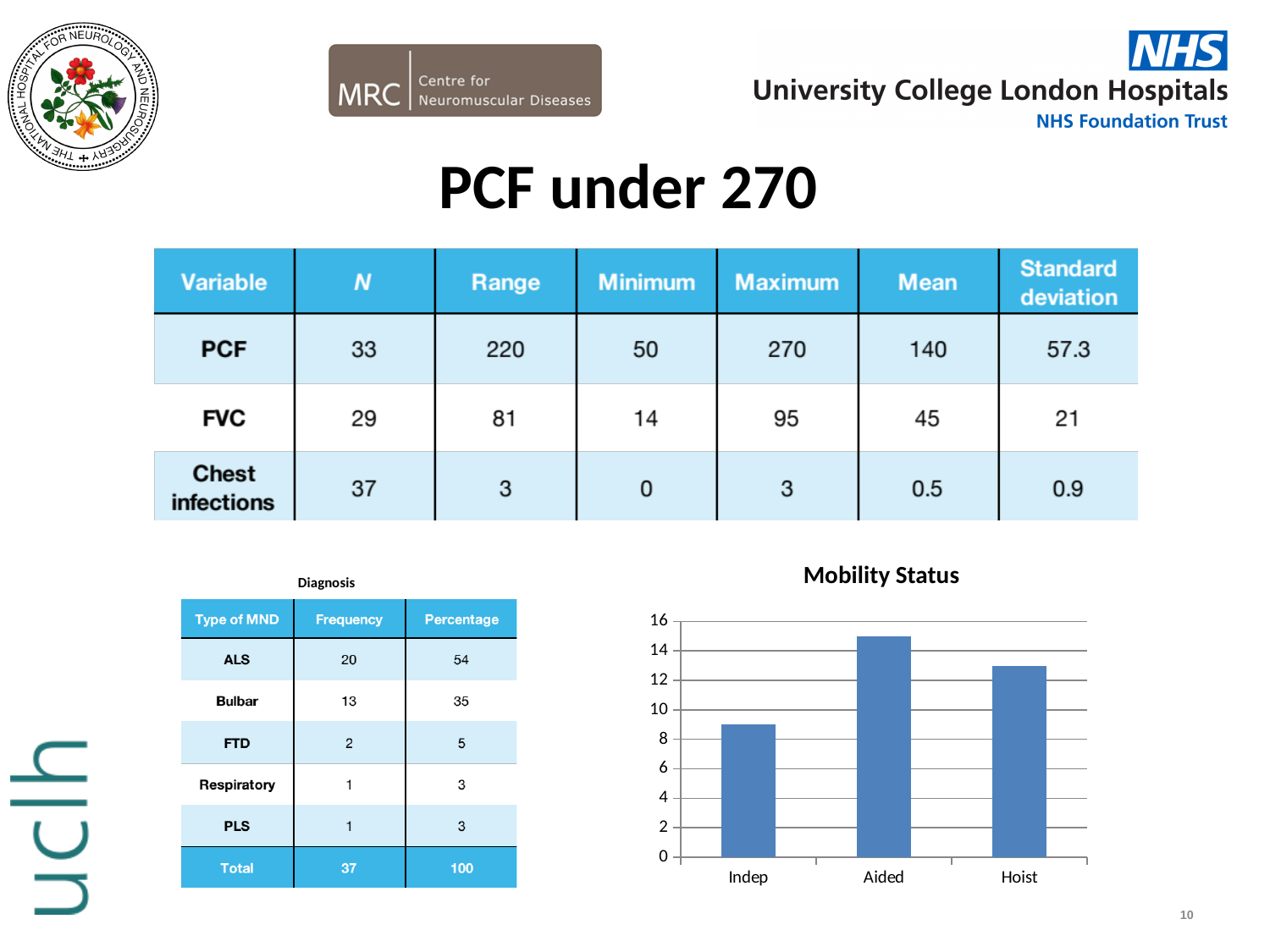
What is the maximum value shown on the y axis of the Mobility Status chart? 16 How many categories are shown on the x axis of the Mobility Status chart? 3 In the Mobility Status chart, is the value for Indep greater or less than 10? less In the Mobility Status chart, is the value for Hoist greater or less than 12? greater What kind of chart is the Mobility Status chart? bar chart What is the title of the bar chart on the slide? Mobility Status Which category has the lowest bar in the Mobility Status chart? Indep In the Mobility Status chart, which is larger, the value for Indep or the value for Hoist? Hoist Which category has the highest bar in the Mobility Status chart? Aided In the Mobility Status chart, which is larger, the value for Aided or the value for Hoist? Aided In the Mobility Status chart, is the value for Aided greater or less than 14? greater